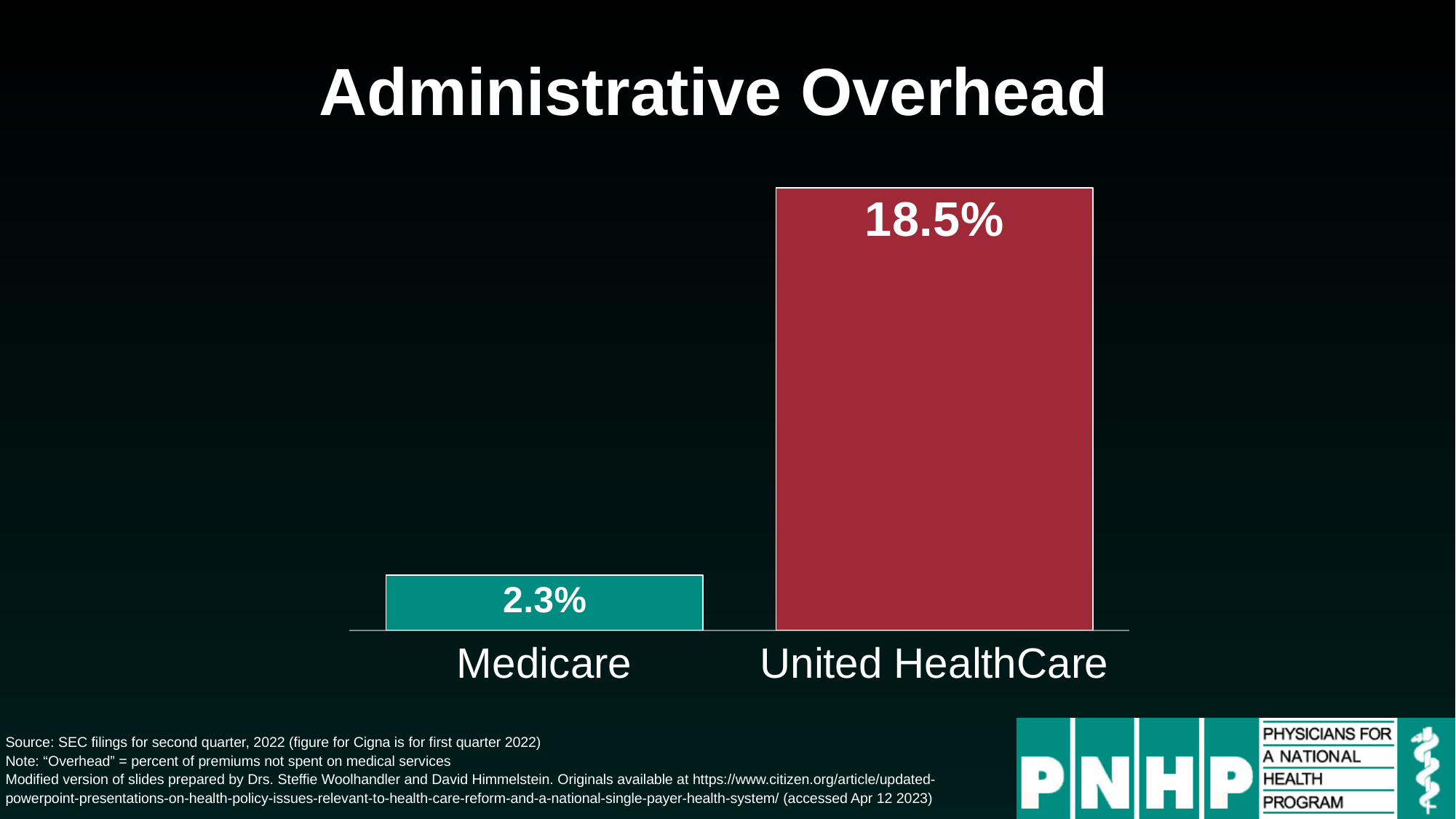
Which category has the lowest administrative overhead? Medicare Which is larger, the overhead for Medicare or for United HealthCare? United HealthCare What is the administrative overhead value for United HealthCare? 18.5% What is the title of the slide? Administrative Overhead What kind of chart is shown on the slide? Bar chart What is the difference between the United HealthCare and Medicare overhead values? 16.2% What colour is the bar for United HealthCare? Red What is the administrative overhead value for Medicare? 2.3% How many categories are shown in the chart? 2 Which category has the highest administrative overhead? United HealthCare